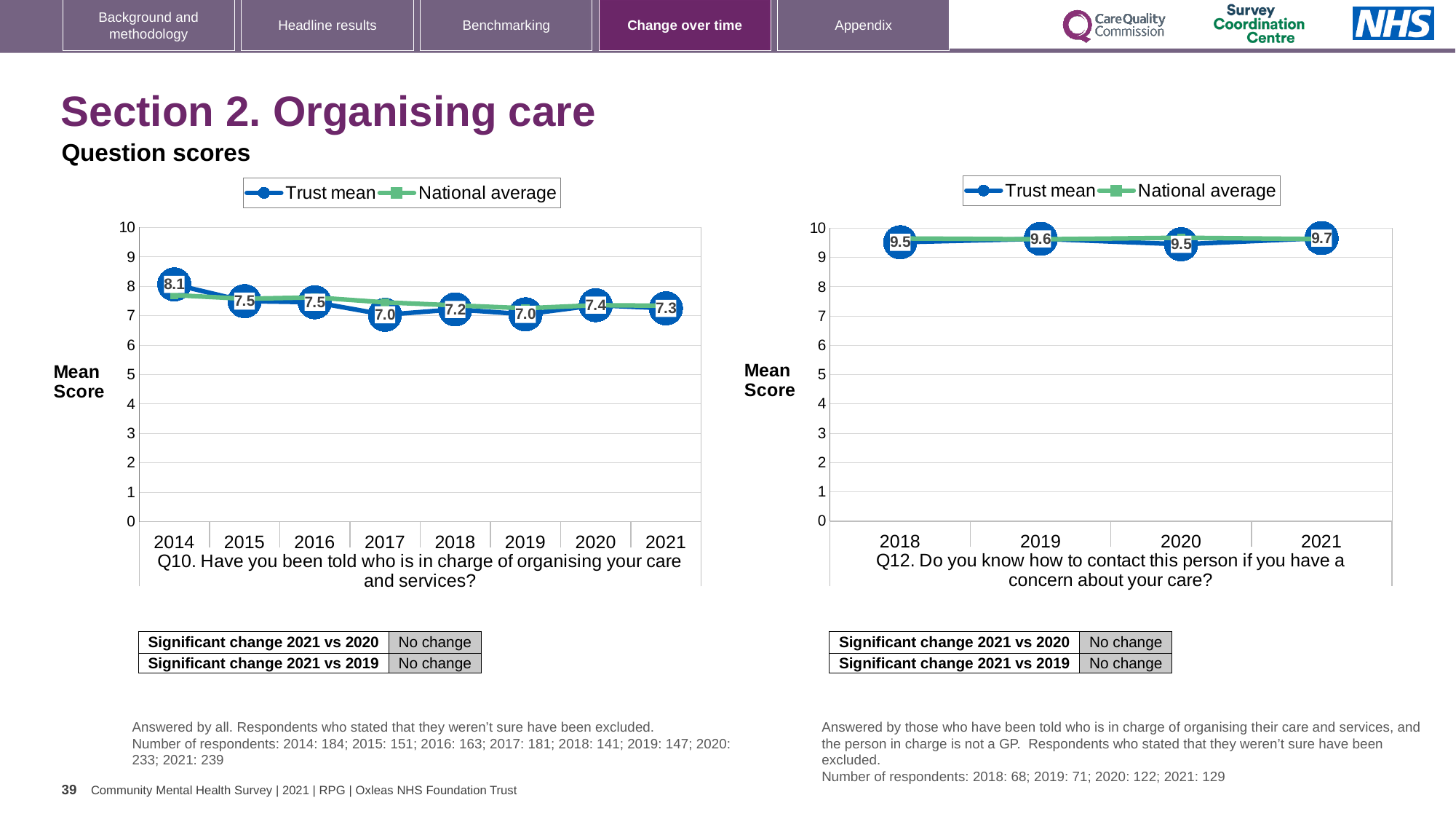
In the Q10 chart on the left, what is the difference between the Trust mean in 2014 and in 2021? 0.8 In the Q10 chart on the left, what is the Trust mean for 2021? 7.3 In the Q12 chart on the right, what is the Trust mean for 2019? 9.6 In the Q10 chart on the left, is the Trust mean for 2017 greater or less than 8? less In the Q10 chart on the left, how many years are plotted on the x axis? 8 In the Q12 chart on the right, what is the Trust mean for 2021? 9.7 In the Q12 chart on the right, is the Trust mean for 2020 greater or less than 9? greater In the Q12 chart on the right, how many years are plotted on the x axis? 4 What type of chart is the Q12 chart on the right? Line chart In the Q12 chart on the right, how many series does the legend list? 2 In the Q10 chart on the left, what is the Trust mean for 2014? 8.1 In the Q10 chart on the left, which year has the highest Trust mean? 2014